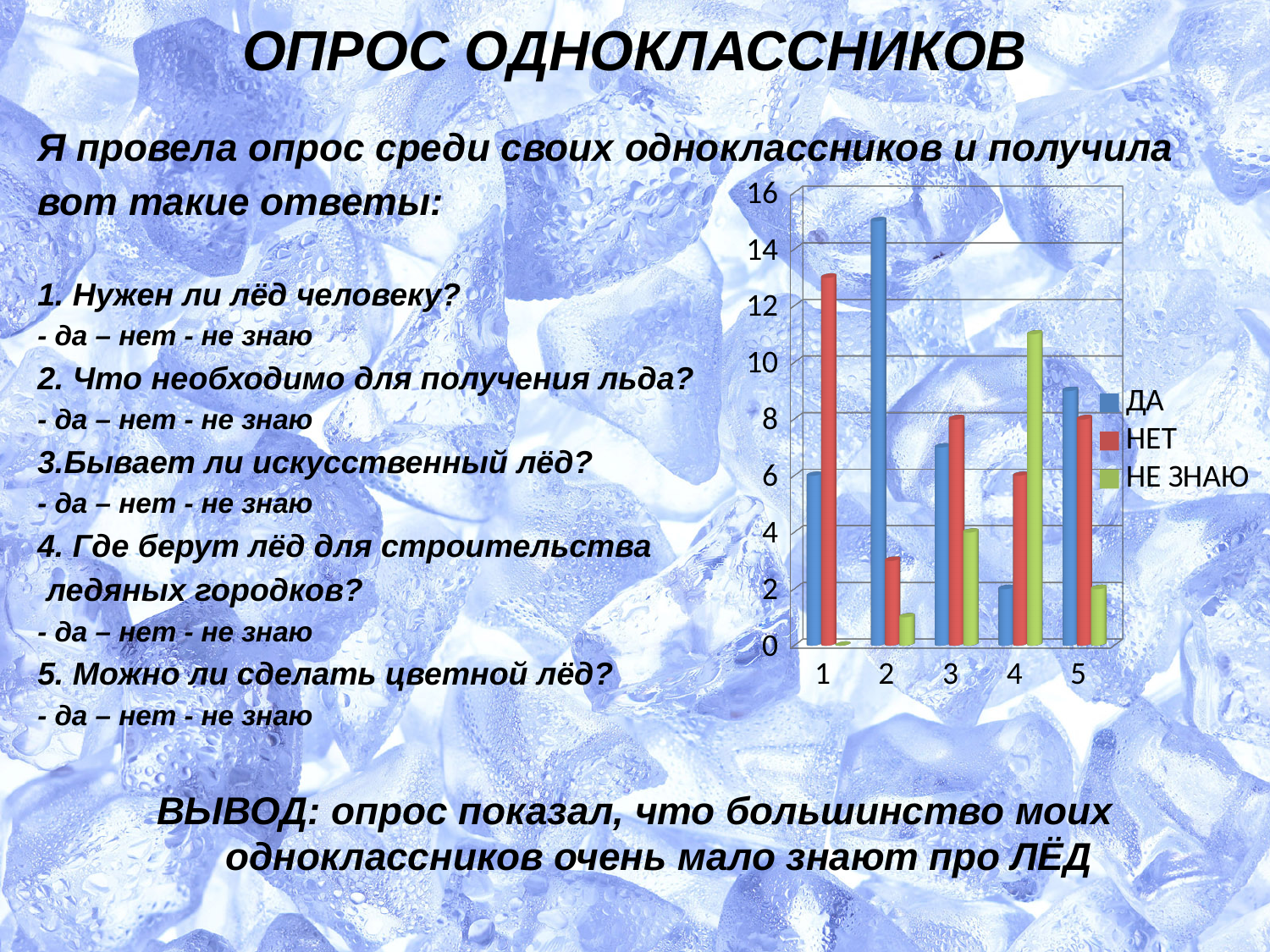
For category 4, which is larger: ДА or НЕ ЗНАЮ? НЕ ЗНАЮ What kind of chart is shown on the slide? bar chart Is the ДА value for category 2 greater or less than 14? greater What are the entries in the chart legend? ДА, НЕТ, НЕ ЗНАЮ Which category has the highest ДА value? 2 Is the НЕТ value for category 2 greater or less than 4? less How many series does the chart legend list? 3 Which category has the lowest НЕ ЗНАЮ value? 1 Is the НЕ ЗНАЮ value for category 4 greater or less than 10? greater For category 1, which is larger: ДА or НЕТ? НЕТ How many categories are shown on the x axis of the chart? 5